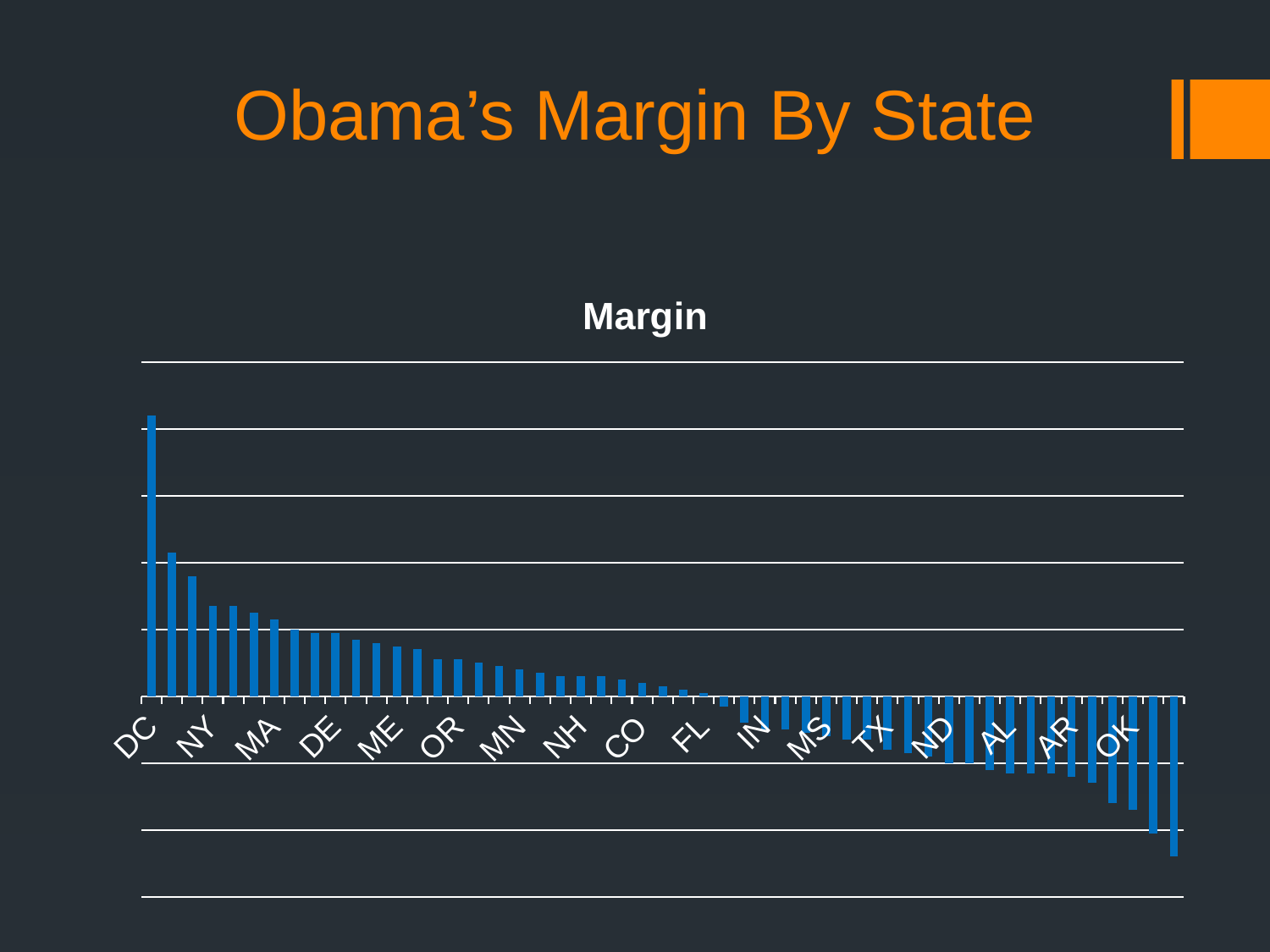
Which has the larger margin, DC or NY? DC Is the bar for CO above or below the zero baseline? above What is the title of the slide? Obama's Margin By State Is the bar for OK above or below the zero baseline? below Which has the larger margin, OR or OK? OR What is the title of the chart? Margin Which labeled state has the highest margin? DC Which has the larger margin, NY or MA? NY What kind of chart is shown on the slide? bar chart Do the bar values rise or fall moving from left to right along the x axis? fall